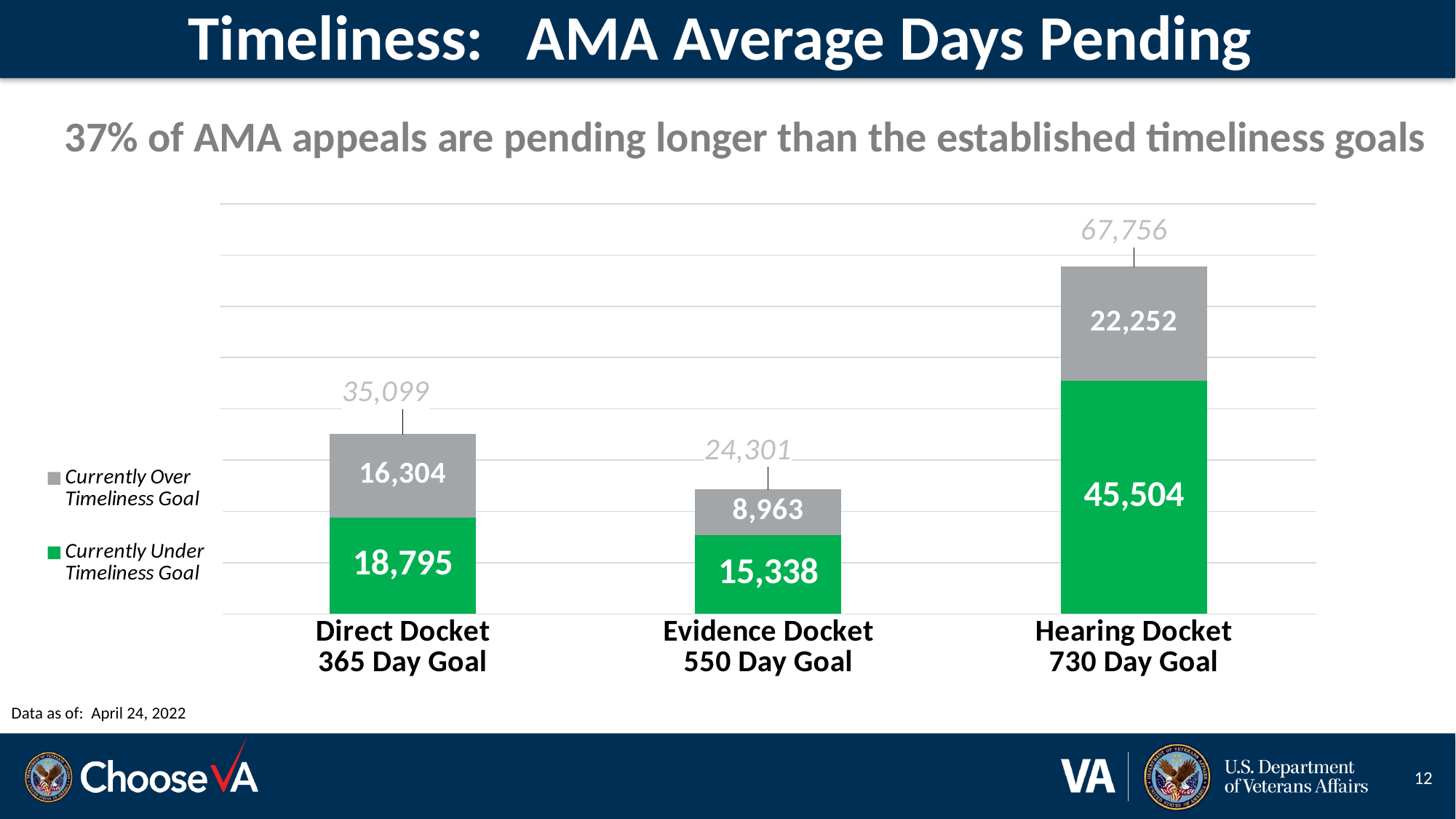
What is the value for Currently Over Timeliness Goal for the Evidence Docket? 8,963 How many series does the legend list? 2 Which docket has the lowest value for Currently Over Timeliness Goal? Evidence Docket What is the value for Currently Under Timeliness Goal for the Direct Docket? 18,795 What is the total of the stacked bar for the Evidence Docket? 24,301 Which is larger: the Currently Under Timeliness Goal value for the Direct Docket or for the Evidence Docket? Direct Docket Which docket has the highest total number of appeals? Hearing Docket What is the value for Currently Under Timeliness Goal for the Hearing Docket? 45,504 What is the difference between the Currently Over Timeliness Goal values for the Hearing Docket and the Direct Docket? 5,948 How many dockets are shown on the chart? 3 What is the total of the stacked bar for the Hearing Docket? 67,756 What kind of chart is shown on the slide? Stacked bar chart